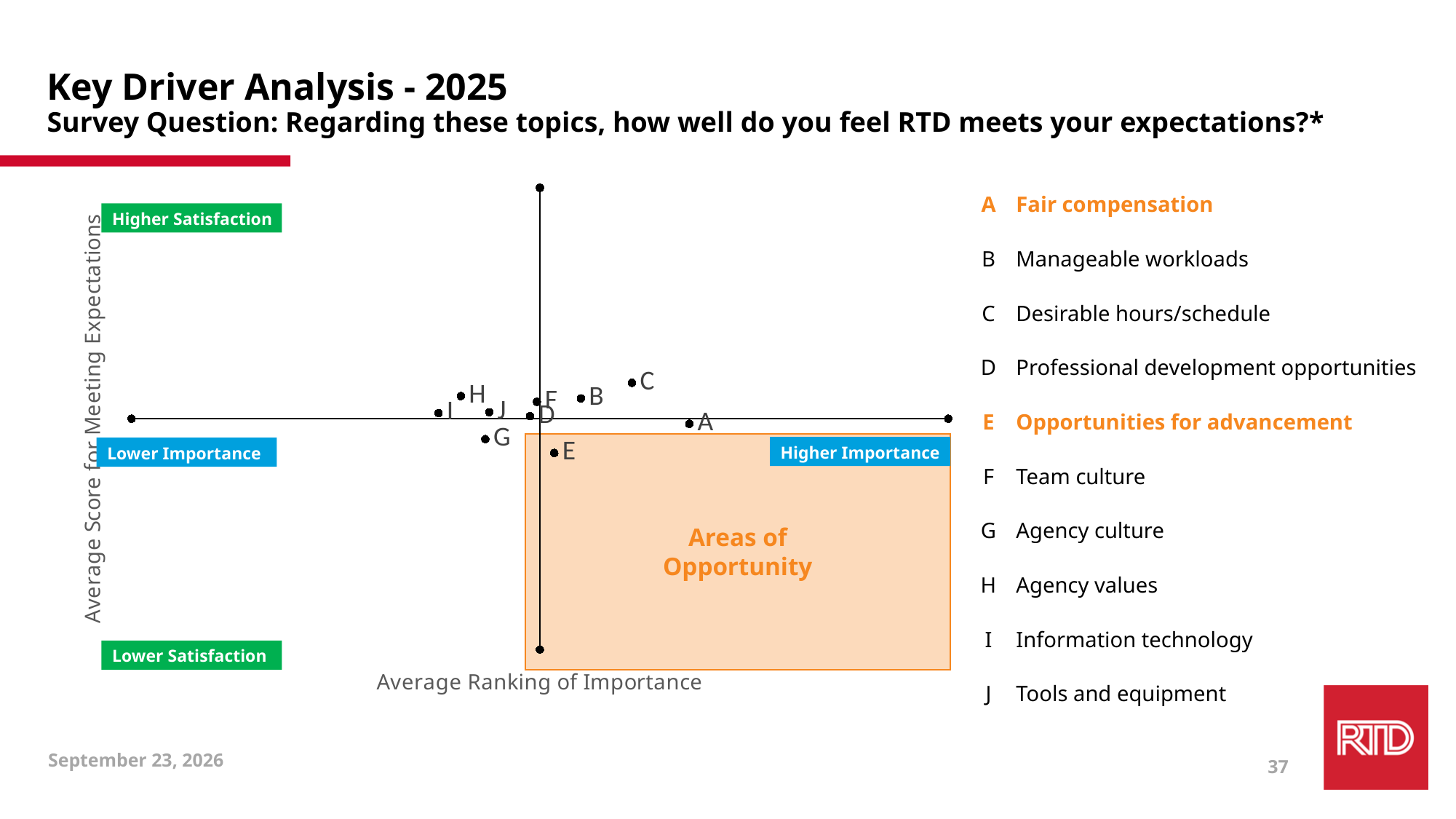
What is the label of the horizontal axis? Average Ranking of Importance Which labeled point has the lowest average score for meeting expectations? E What kind of chart is shown on the slide? Scatter plot Which labeled point lies inside the shaded 'Areas of Opportunity' region? E Which labeled point has the highest average ranking of importance (furthest right)? A Which two topics in the key are highlighted in orange? A Fair compensation and E Opportunities for advancement Which point has a higher average score for meeting expectations, H or G? H How many labeled data points are plotted on the chart? 10 Which point has a higher average ranking of importance, A or I? A Which labeled point has the highest average score for meeting expectations? C Which labeled point has the lowest average ranking of importance (furthest left)? I Which point has a higher average score for meeting expectations, C or E? C